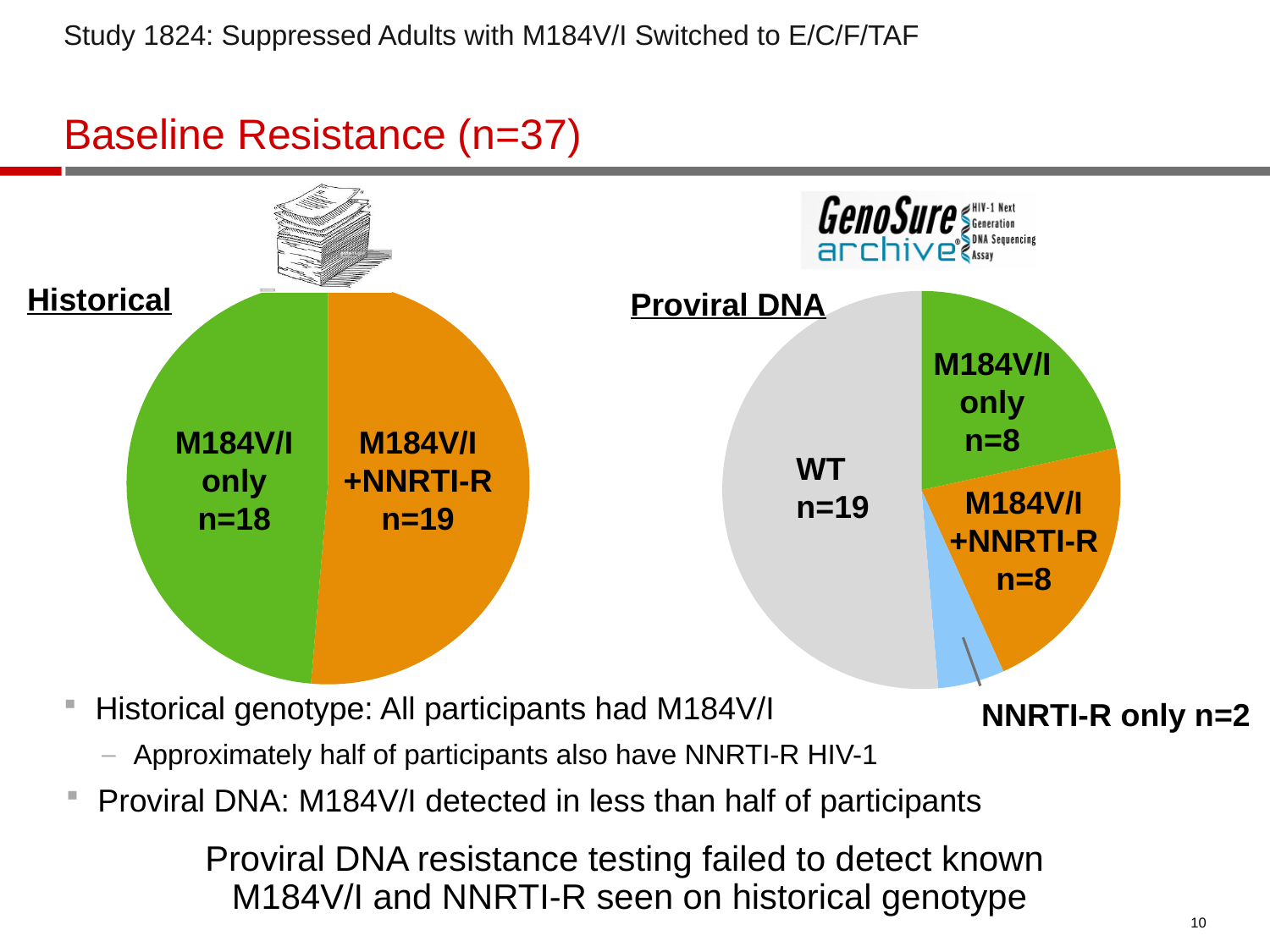
In the Proviral DNA chart, which category has the largest slice? WT In the Proviral DNA chart, what is the value for NNRTI-R only? n=2 In the Historical chart, what is the difference between M184V/I +NNRTI-R and M184V/I only? 1 In the Proviral DNA chart, what colour is the WT slice? grey What type of chart is the Historical chart? pie chart In the Proviral DNA chart, which category has the smallest slice? NNRTI-R only In the Historical chart, what is the value for M184V/I +NNRTI-R? n=19 In the Proviral DNA chart, what is the value for WT? n=19 In the Proviral DNA chart, how many slices are there? 4 In the Historical chart, how many slices are there? 2 In the Proviral DNA chart, what is the difference between WT and M184V/I only? 11 In the Historical chart, what is the value for M184V/I only? n=18